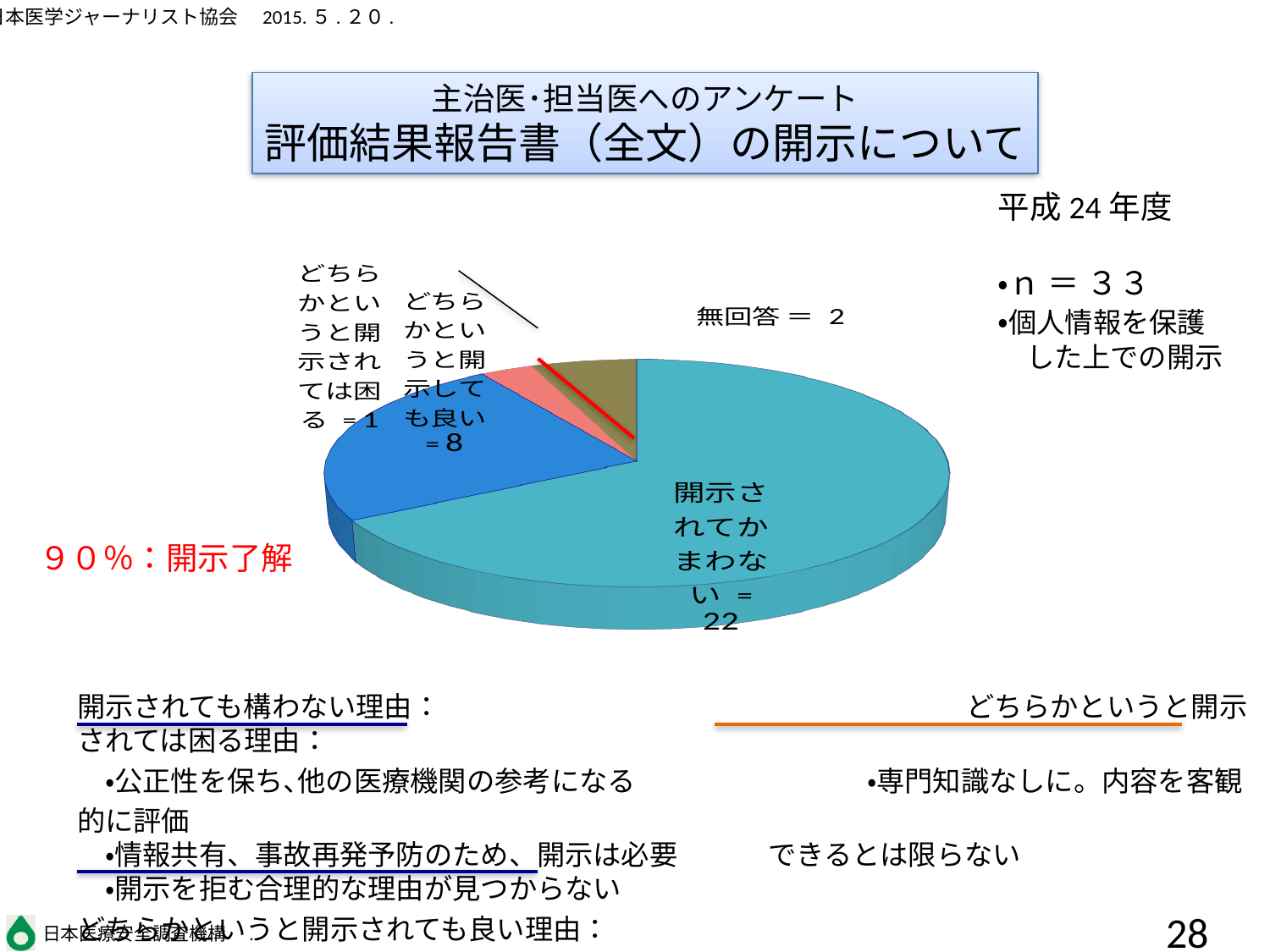
What is the title of the chart on the slide? 主治医・担当医へのアンケート 評価結果報告書（全文）の開示について What kind of chart is shown on the slide? pie chart What is the total of all slices in the pie chart? 33 How many slices does the pie chart have? 4 What is the value for 無回答 in the pie chart? 2 What is the difference between the values for 開示されてかまわない and どちらかというと開示しても良い? 14 Which category has the smallest slice in the pie chart? どちらかというと開示されては困る What is the value for どちらかというと開示されては困る in the pie chart? 1 Which is larger, the value for 無回答 or the value for どちらかというと開示されては困る? 無回答 Which category has the largest slice in the pie chart? 開示されてかまわない What is the value for どちらかというと開示しても良い in the pie chart? 8 What is the value for 開示されてかまわない in the pie chart? 22